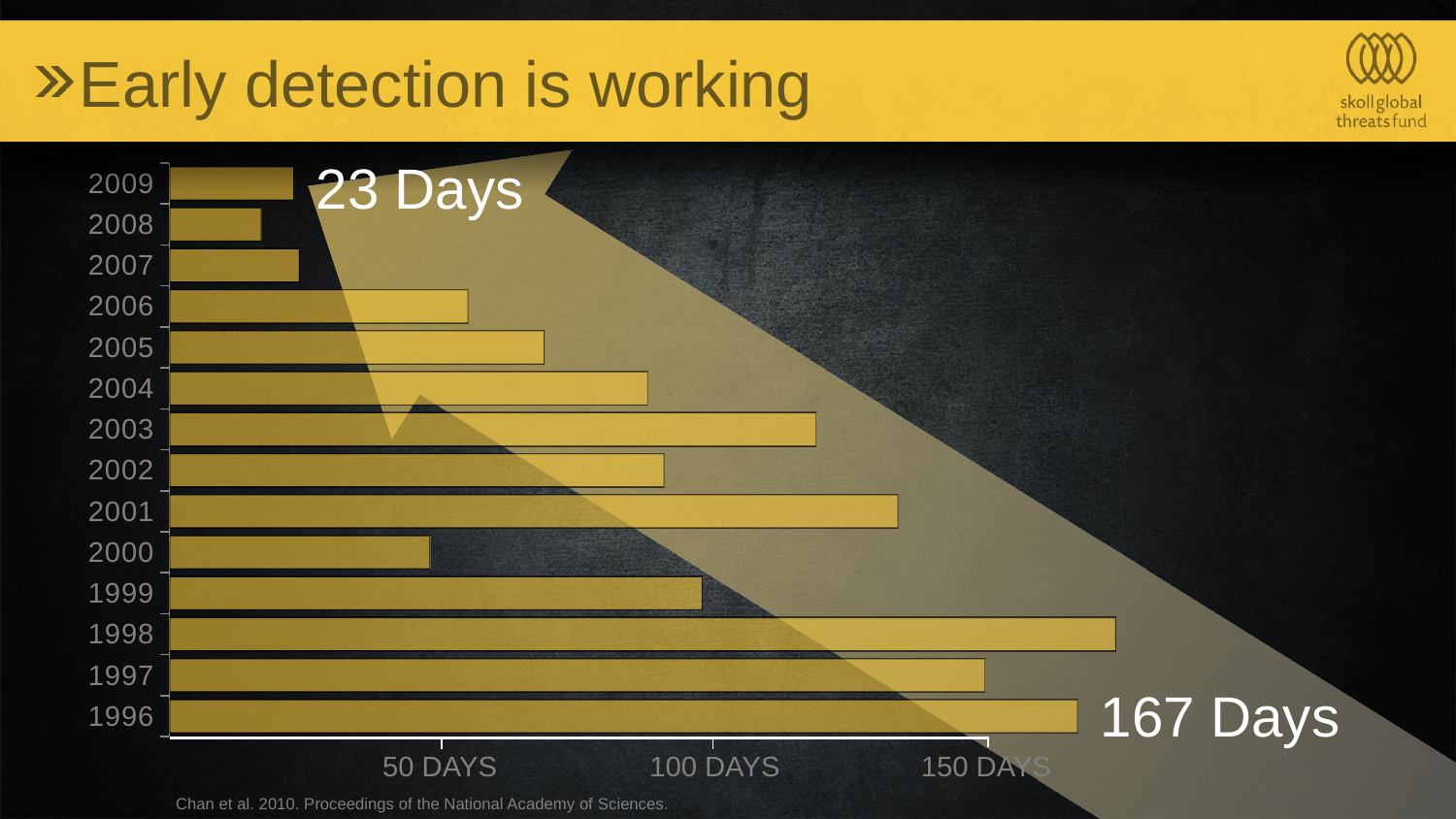
Is the value for 2003 greater or less than 100 days? greater What value is labeled for 2009 on the chart? 23 Days What is the difference between the labeled values for 1996 and 2009? 144 Days What kind of chart is shown on the slide? Bar chart Is the value for 1998 greater or less than 150 days? greater What value is labeled for 1996 on the chart? 167 Days Which year has the larger value, 2005 or 2006? 2005 How many years are shown on the chart? 14 Which year has the larger value, 2003 or 2002? 2003 Is the value for 2004 greater or less than 100 days? less Which year has the shortest bar on the chart? 2008 From 1996 to 2009, do the values on the chart generally rise or fall? Fall